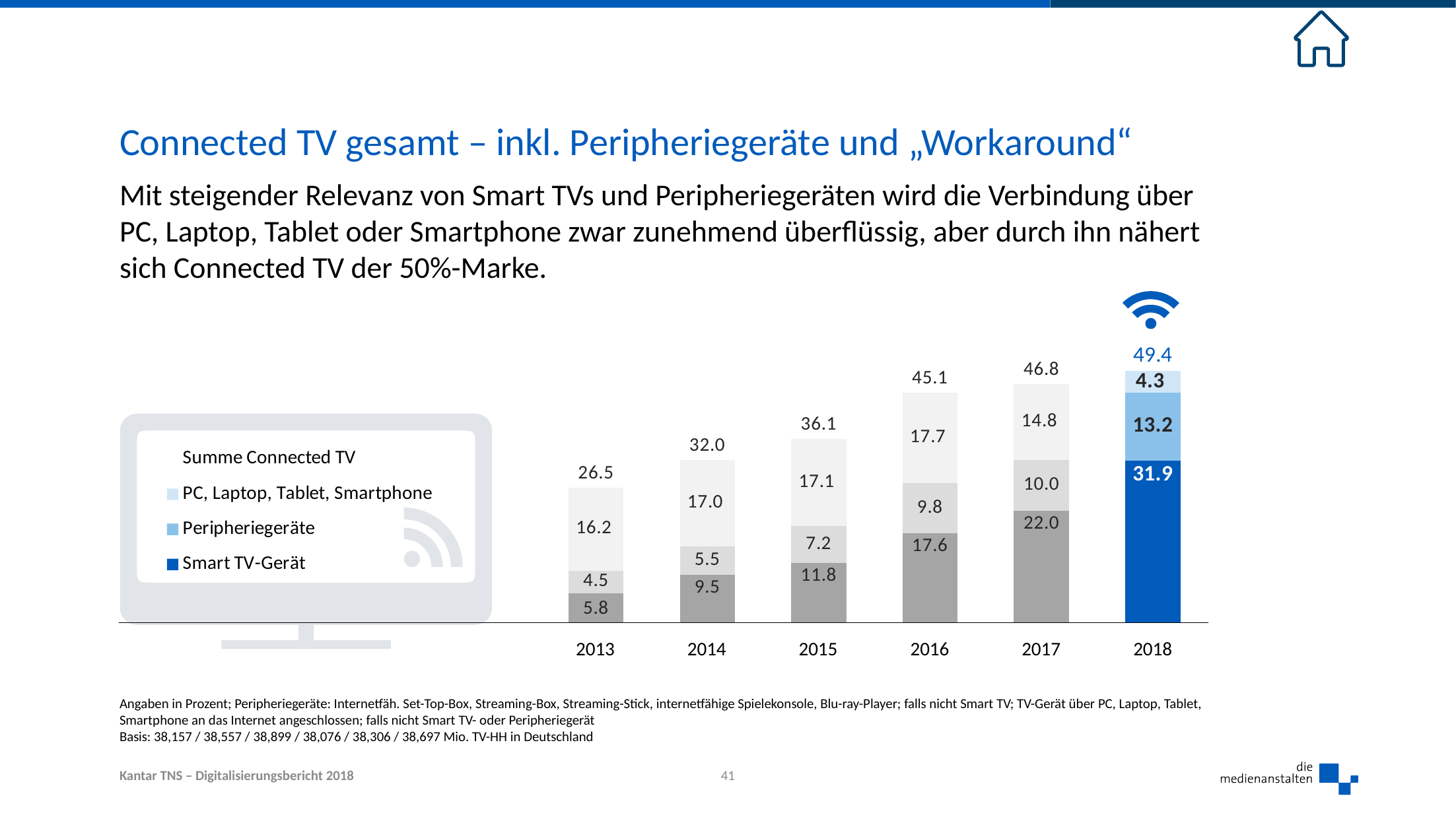
How many years are shown on the x axis? 6 What is the Summe Connected TV total shown for 2015? 36.1 What is the Peripheriegeräte value for 2016? 9.8 Which is larger, the PC, Laptop, Tablet, Smartphone value for 2017 or for 2018? 2017 Which year has the highest Summe Connected TV total? 2018 What is the Smart TV-Gerät value for 2018? 31.9 How many series does the legend list (excluding the Summe Connected TV total)? 3 Do the Smart TV-Gerät values rise or fall from 2013 to 2018? Rise What is the difference between the Smart TV-Gerät values for 2018 and 2017? 9.9 Which year has the lowest Smart TV-Gerät value? 2013 What kind of chart is shown on the slide? Stacked bar chart What is the PC, Laptop, Tablet, Smartphone value for 2013? 16.2